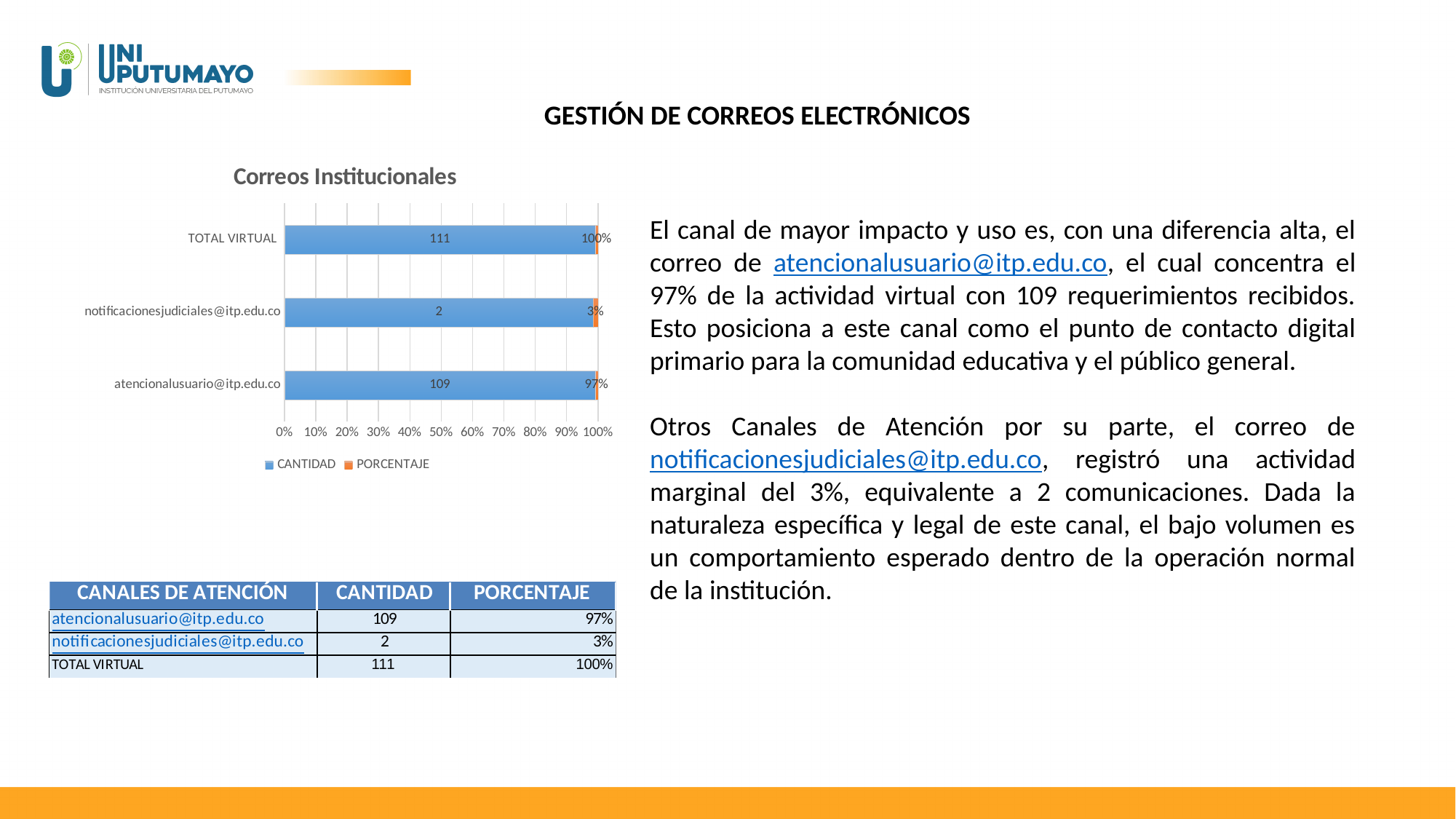
What is the CANTIDAD value for atencionalusuario@itp.edu.co in the chart? 109 What PORCENTAJE value is labelled for atencionalusuario@itp.edu.co in the chart? 97% What is the difference in CANTIDAD between atencionalusuario@itp.edu.co and notificacionesjudiciales@itp.edu.co? 107 What is the CANTIDAD value for TOTAL VIRTUAL in the chart? 111 What type of chart is "Correos Institucionales"? bar chart What PORCENTAJE value is labelled for notificacionesjudiciales@itp.edu.co in the chart? 3% How many series does the legend of the "Correos Institucionales" chart list? 2 What are the two series names listed in the chart legend? CANTIDAD and PORCENTAJE What is the CANTIDAD value for notificacionesjudiciales@itp.edu.co in the chart? 2 How many categories are shown in the "Correos Institucionales" chart? 3 Which category has the lowest CANTIDAD value in the chart? notificacionesjudiciales@itp.edu.co Which has a larger CANTIDAD value: atencionalusuario@itp.edu.co or notificacionesjudiciales@itp.edu.co? atencionalusuario@itp.edu.co